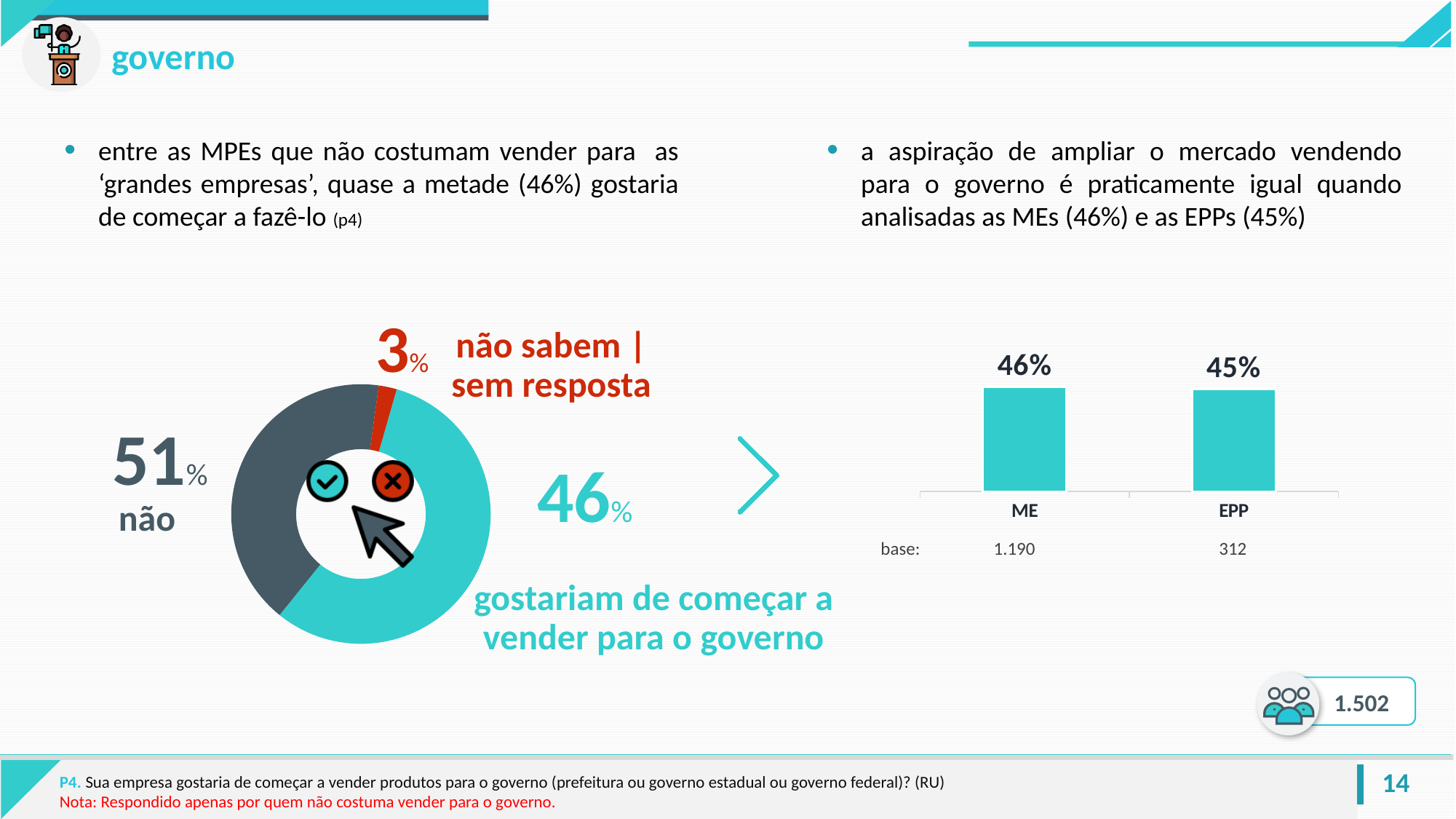
In the donut chart on the left, which category has the smallest share? não sabem | sem resposta In the donut chart on the left, what is the difference in percentage points between 'não' and 'gostariam de começar a vender para o governo'? 5 percentage points In the donut chart on the left, how many slices are shown? 3 In the bar chart on the right, what is the value for EPP? 45% In the donut chart on the left, what share of respondents answered 'não'? 51% In the donut chart on the left, what share is 'não sabem | sem resposta'? 3% In the donut chart on the left, which category has the largest share? não In the bar chart on the right, what is the value for ME? 46% In the bar chart on the right, what is the base (number of respondents) for EPP? 312 In the donut chart on the left, what share of respondents 'gostariam de começar a vender para o governo'? 46% In the bar chart on the right, what is the base (number of respondents) for ME? 1.190 What type of chart is shown on the right side of the slide? bar chart